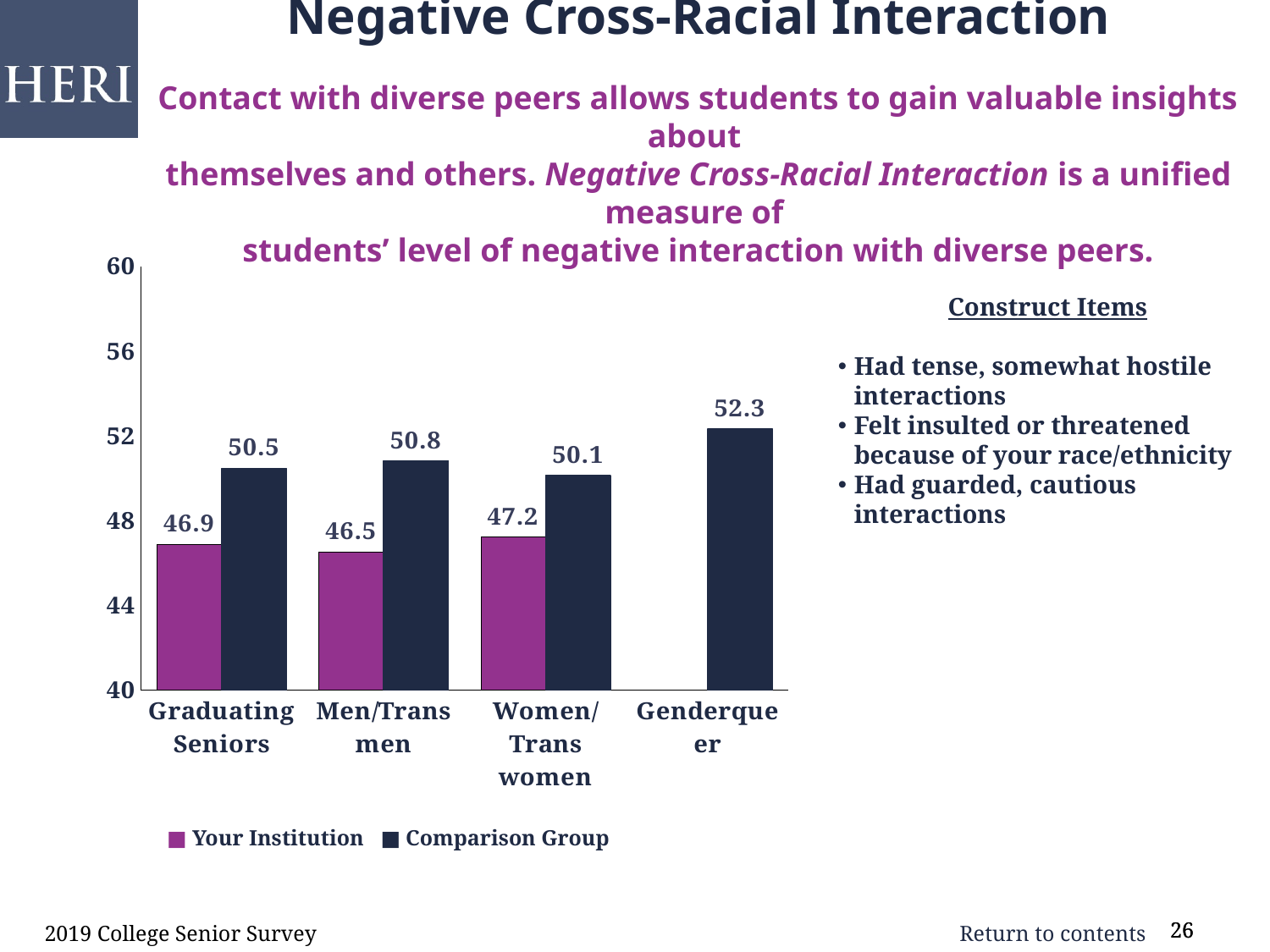
What is the value for Comparison Group for Men/Trans men? 50.8 What is the value for Comparison Group for Genderqueer? 52.3 Which category has the highest Comparison Group value? Genderqueer Which is larger for Men/Trans men: Your Institution or Comparison Group? Comparison Group Is the Comparison Group value for Women/Trans women greater or less than 48? greater Which category has the lowest Your Institution value? Men/Trans men What is the value for Your Institution for Women/Trans women? 47.2 What is the difference between the Comparison Group and Your Institution values for Graduating Seniors? 3.6 How many categories are shown on the x axis? 4 What kind of chart is shown on the slide? bar chart What is the value for Your Institution for Graduating Seniors? 46.9 How many series does the legend list? 2